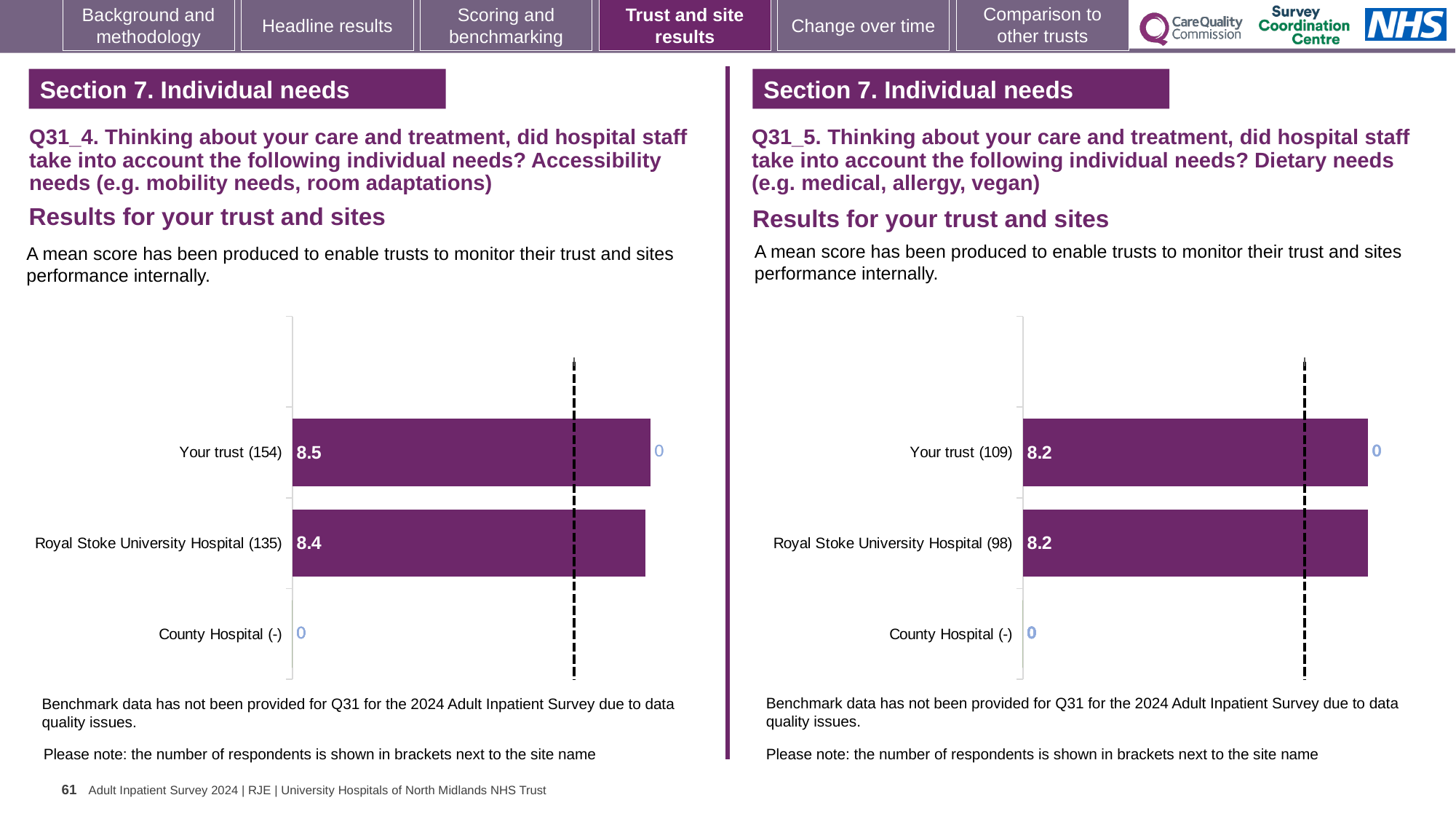
In the left chart (Q31_4, accessibility needs), what is the mean score for Your trust (154)? 8.5 In the right chart (Q31_5, dietary needs), what is the mean score for Your trust (109)? 8.2 In the right chart (Q31_5, dietary needs), what value is shown for County Hospital (-)? 0 In the left chart (Q31_4, accessibility needs), what is the difference between the scores for Your trust (154) and Royal Stoke University Hospital (135)? 0.1 In the right chart (Q31_5, dietary needs), what is the mean score for Royal Stoke University Hospital (98)? 8.2 In the left chart (Q31_4, accessibility needs), what is the mean score for Royal Stoke University Hospital (135)? 8.4 In the left chart (Q31_4, accessibility needs), how many respondents are shown in brackets for Royal Stoke University Hospital? 135 In the left chart (Q31_4, accessibility needs), which category has the highest mean score? Your trust (154) How many categories are shown in the right chart (Q31_5, dietary needs)? 3 In the left chart (Q31_4, accessibility needs), which is larger: the score for Your trust (154) or for Royal Stoke University Hospital (135)? Your trust (154) What is the difference between the Your trust scores in the left chart (Q31_4) and the right chart (Q31_5)? 0.3 What kind of chart is the left chart (Q31_4, accessibility needs)? Bar chart